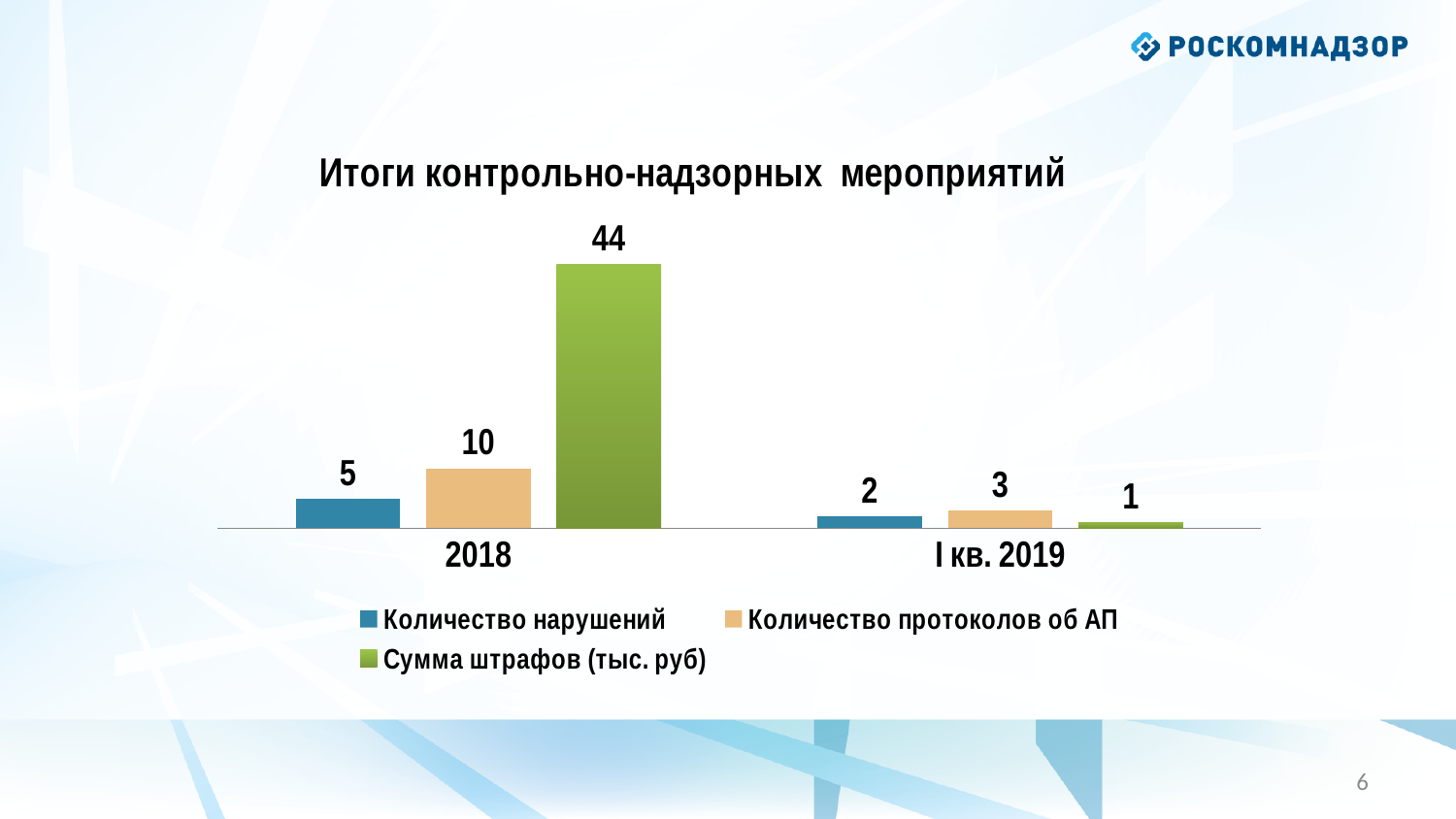
What is the value of Количество нарушений for 2018? 5 How many series does the legend list? 3 What is the difference between Количество протоколов об АП and Количество нарушений in 2018? 5 What is the value of Сумма штрафов (тыс. руб) for I кв. 2019? 1 Which is larger: Количество нарушений in 2018 or Количество протоколов об АП in I кв. 2019? Количество нарушений in 2018 How many categories are shown on the x axis? 2 What is the difference between Сумма штрафов (тыс. руб) in 2018 and in I кв. 2019? 43 Which series has the highest value in 2018? Сумма штрафов (тыс. руб) What kind of chart is shown on the slide? Bar chart What is the title of the chart? Итоги контрольно-надзорных мероприятий What is the value of Количество протоколов об АП for 2018? 10 Which series has the lowest value in I кв. 2019? Сумма штрафов (тыс. руб)